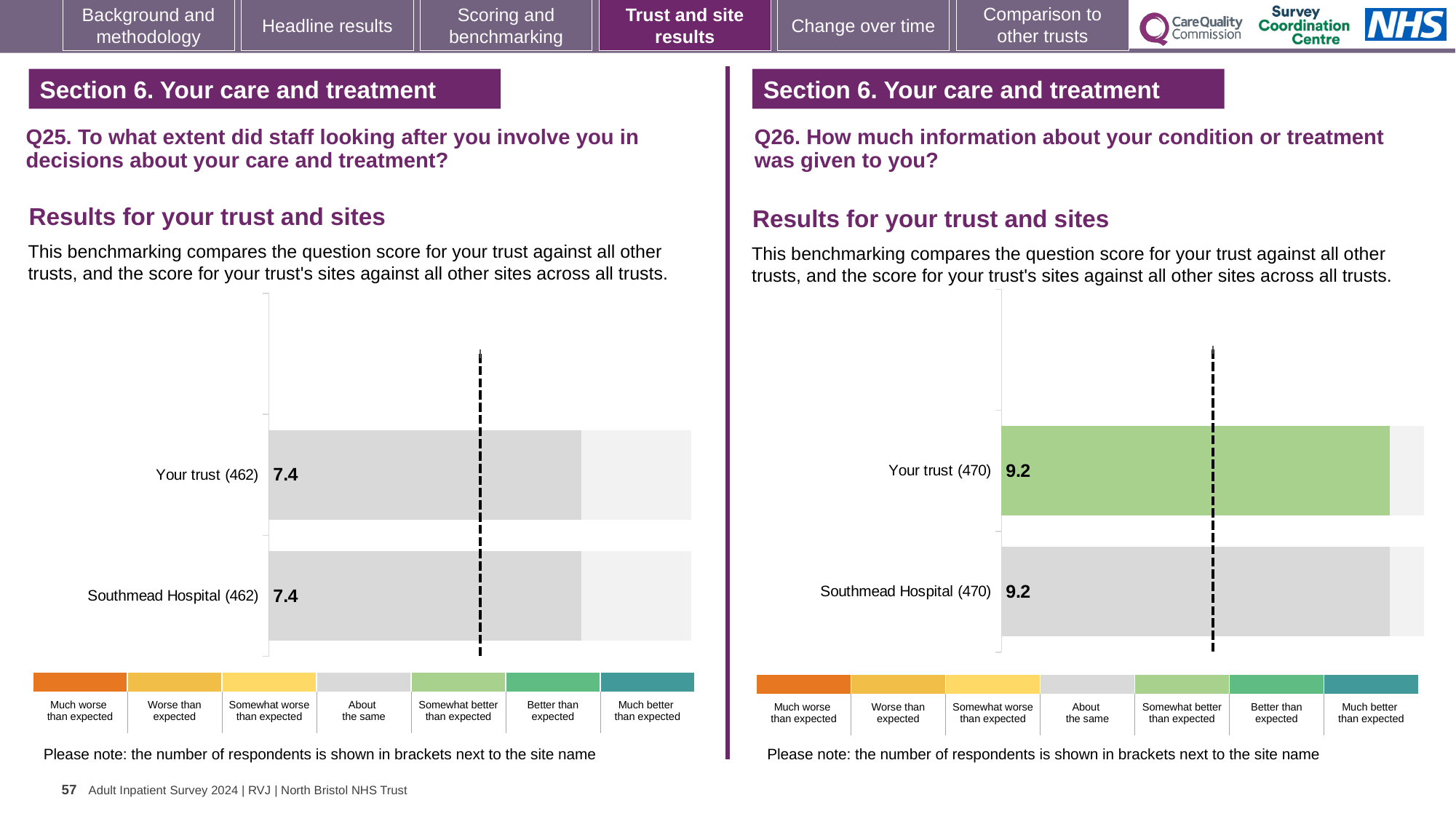
In the Q26 chart on the right, what is the difference between the scores for Your trust and Southmead Hospital? 0 In the Q26 chart on the right, which benchmark category does the colour of the Your trust (470) bar correspond to? Somewhat better than expected In the Q25 chart on the left, what is the score for Your trust (462)? 7.4 What kind of chart is used for the Q25 results on the left? Bar chart In the Q26 chart on the right, what is the score for Southmead Hospital (470)? 9.2 How many bars are plotted in the Q26 chart on the right? 2 In the Q26 chart on the right, what is the score for Your trust (470)? 9.2 In the Q25 chart on the left, what is the difference between the scores for Your trust and Southmead Hospital? 0 How many respondents are shown in brackets for Southmead Hospital in the Q26 chart on the right? 470 In the Q25 chart on the left, which benchmark category does the colour of the Your trust (462) bar correspond to? About the same How many bars are plotted in the Q25 chart on the left? 2 In the Q25 chart on the left, what is the score for Southmead Hospital (462)? 7.4